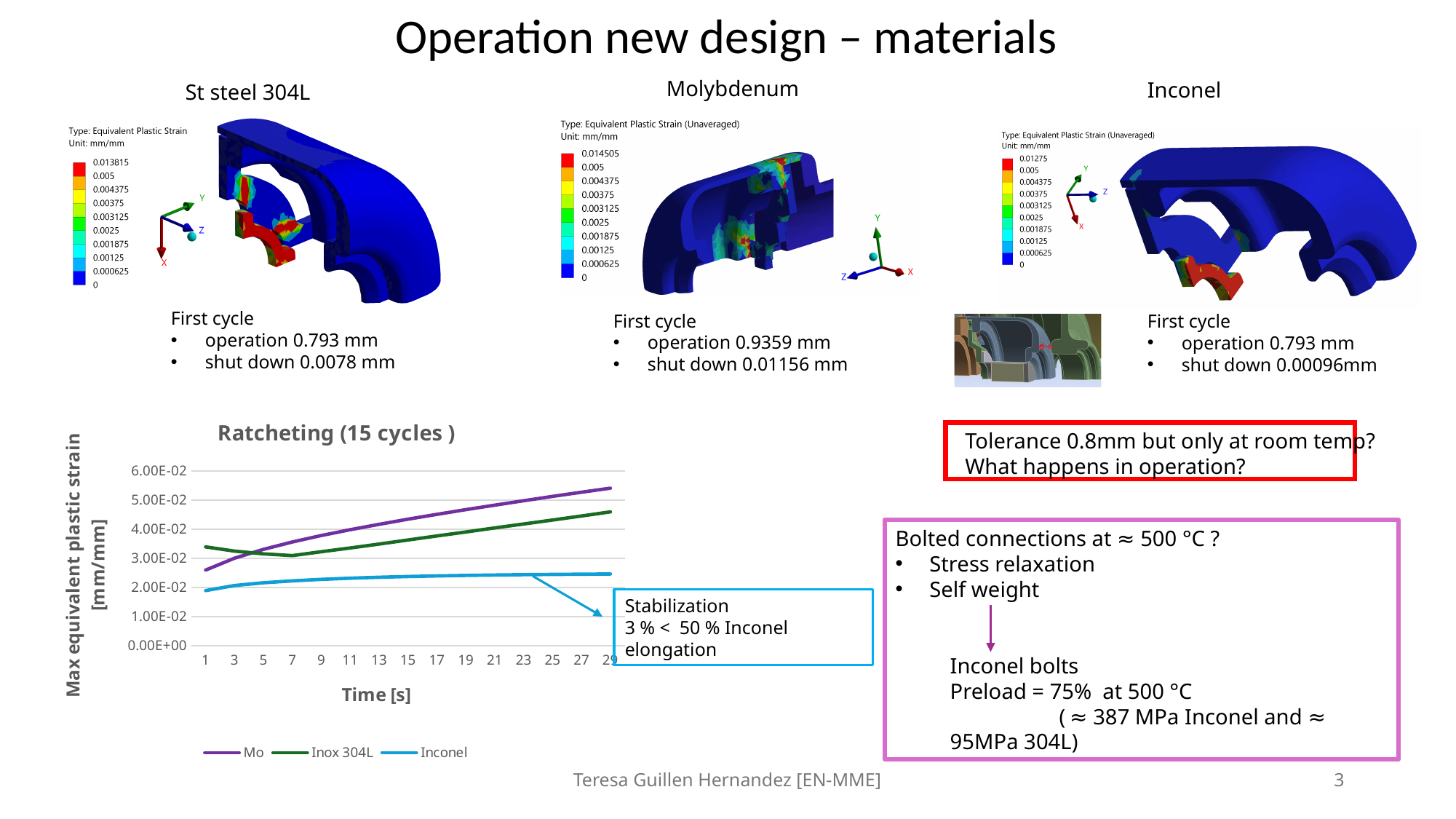
In the 'Ratcheting (15 cycles )' chart, which series has the lowest value at time 29? Inconel Which series are listed in the legend of the 'Ratcheting (15 cycles )' chart? Mo, Inox 304L, Inconel In the 'Ratcheting (15 cycles )' chart, is the value for Mo at time 29 greater or less than 5.00E-02? greater In the 'Ratcheting (15 cycles )' chart, which series has the highest value at time 29? Mo What is the x-axis title of the 'Ratcheting (15 cycles )' chart? Time [s] In the 'Ratcheting (15 cycles )' chart, is the value for Inconel at time 29 greater or less than 3.00E-02? less In the 'Ratcheting (15 cycles )' chart, is the value for Mo at time 1 greater or less than 3.00E-02? less In the 'Ratcheting (15 cycles )' chart, does the Mo series rise or fall from time 1 to time 29? rise What kind of chart is the 'Ratcheting (15 cycles )' chart? line chart In the 'Ratcheting (15 cycles )' chart, which series is higher at time 29, Mo or Inox 304L? Mo How many series does the legend of the 'Ratcheting (15 cycles )' chart list? 3 In the 'Ratcheting (15 cycles )' chart, which series is higher at time 1, Mo or Inox 304L? Inox 304L